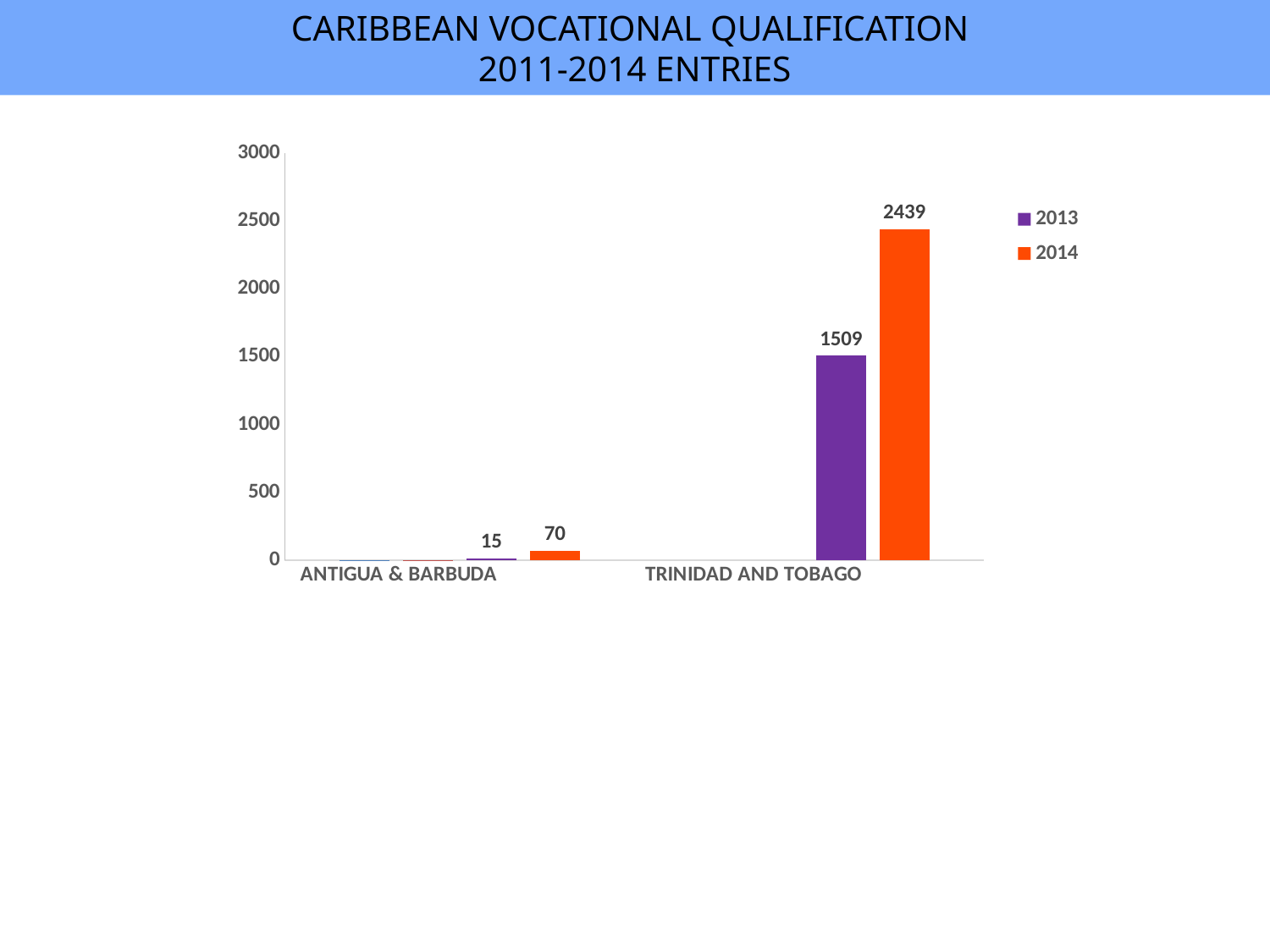
What is the difference between the 2014 and 2013 values for Antigua & Barbuda? 55 What kind of chart is shown on the slide? bar chart What is the value for Trinidad and Tobago in 2013? 1509 What is the value for Trinidad and Tobago in 2014? 2439 Which category has the highest value in 2014? Trinidad and Tobago What is the value for Antigua & Barbuda in 2014? 70 How many categories are shown on the x axis? 2 How many series does the legend list? 2 By how much did entries for Trinidad and Tobago increase from 2013 to 2014? 930 Is the 2013 value for Trinidad and Tobago greater or less than 1000? greater For Trinidad and Tobago, which year has the larger value, 2013 or 2014? 2014 What is the value for Antigua & Barbuda in 2013? 15